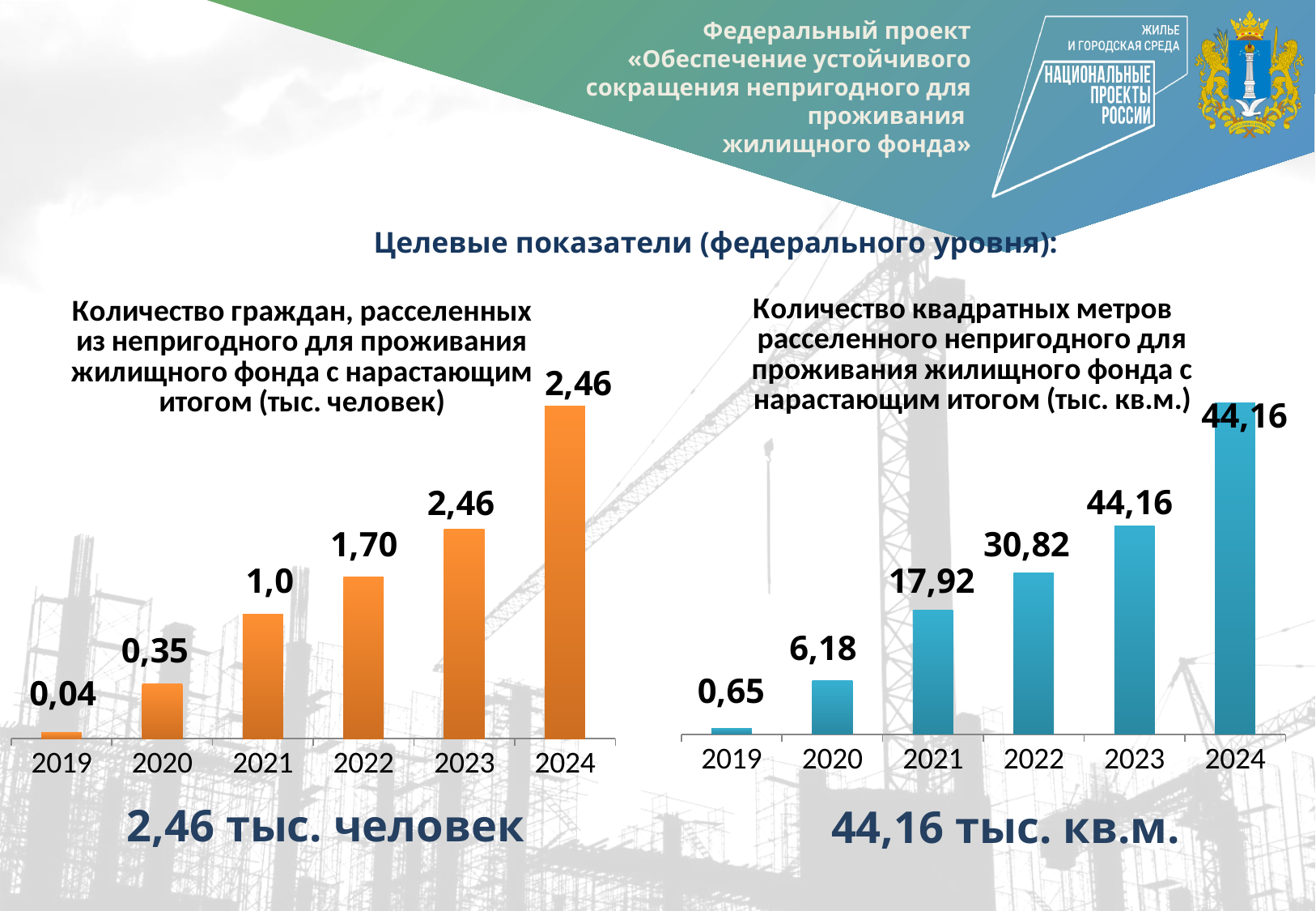
What type of chart is the right chart (Количество квадратных метров)? bar chart In the right chart (Количество квадратных метров), what is the value for 2022? 30,82 In the left chart (Количество граждан, расселенных из непригодного для проживания жилищного фонда), what is the value for 2021? 1,0 In the right chart (Количество квадратных метров), do the values rise or fall from 2019 to 2023? rise In the right chart (Количество квадратных метров), which is larger, the value for 2021 or the value for 2020? 2021 How many years are shown on the x axis of the left chart (Количество граждан)? 6 In the left chart (Количество граждан), what is the difference between the values for 2022 and 2021? 0,70 In the right chart (Количество квадратных метров), what is the value for 2020? 6,18 In the left chart (Количество граждан), what is the value for 2019? 0,04 In the right chart (Количество квадратных метров), what is the difference between the values for 2022 and 2021? 12,90 In the right chart (Количество квадратных метров), which year has the lowest value? 2019 In the left chart (Количество граждан), which year has the lowest value? 2019